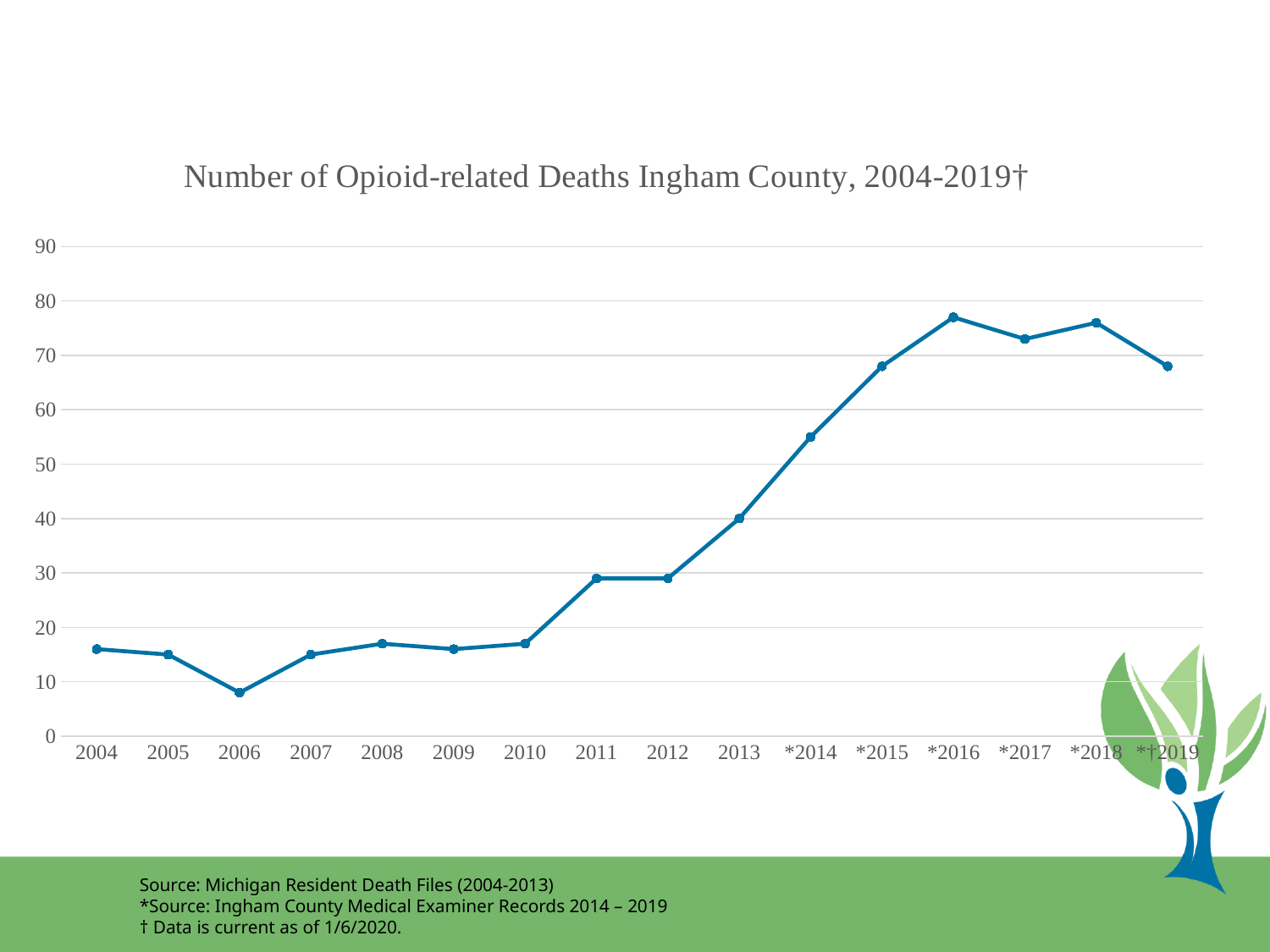
Which is larger, the value for 2010 or the value for 2013? 2013 Is the value for *2014 greater or less than 50? greater Is the value for 2011 greater or less than 40? less Is the value for 2013 greater or less than 30? greater Which year has the lowest number of opioid-related deaths? 2006 Overall, do the values rise or fall from 2004 to 2019? rise What kind of chart is shown on the slide? line chart Which is larger, the value for *2014 or the value for *2017? *2017 What is the title of the chart? Number of Opioid-related Deaths Ingham County, 2004-2019† How many years (data points) are plotted on the chart? 16